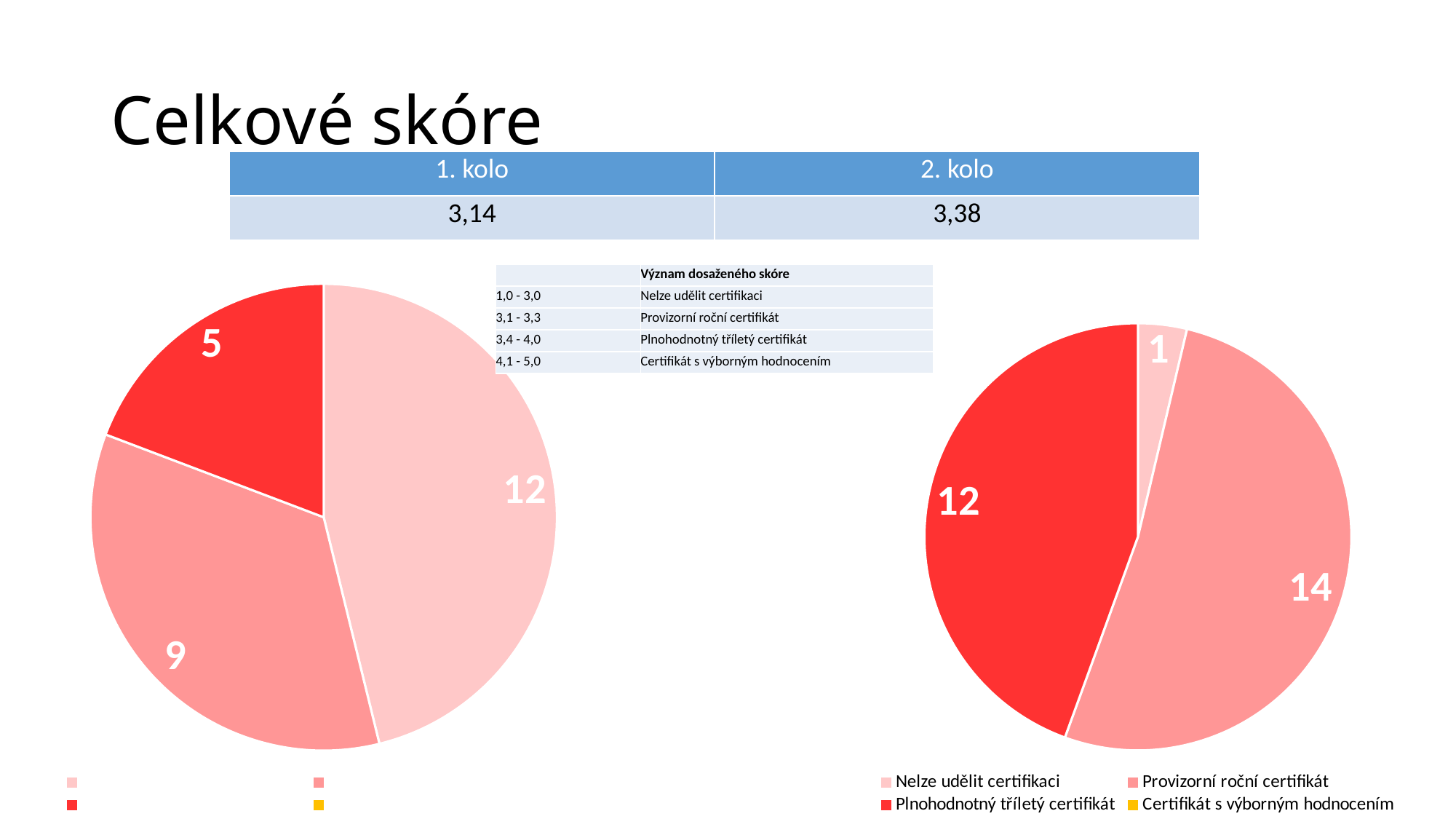
What kind of chart is the left chart on the slide? Pie chart On the right pie chart, which category has the largest slice? Provizorní roční certifikát On the left pie chart, what is the total of all the slice values? 26 On the left pie chart, what is the value of the largest slice? 12 On the right pie chart, what is the difference between the values for Provizorní roční certifikát and Plnohodnotný tříletý certifikát? 2 On the right pie chart, what is the value for Provizorní roční certifikát? 14 On the left pie chart, what is the value of the red slice? 5 On the right pie chart, which category has the smallest slice? Nelze udělit certifikaci On the right pie chart, what is the total of all the slice values? 27 How many entries does the legend of the right pie chart list? 4 On the right pie chart, what is the value for Plnohodnotný tříletý certifikát? 12 On the right pie chart, what is the value for Nelze udělit certifikaci? 1